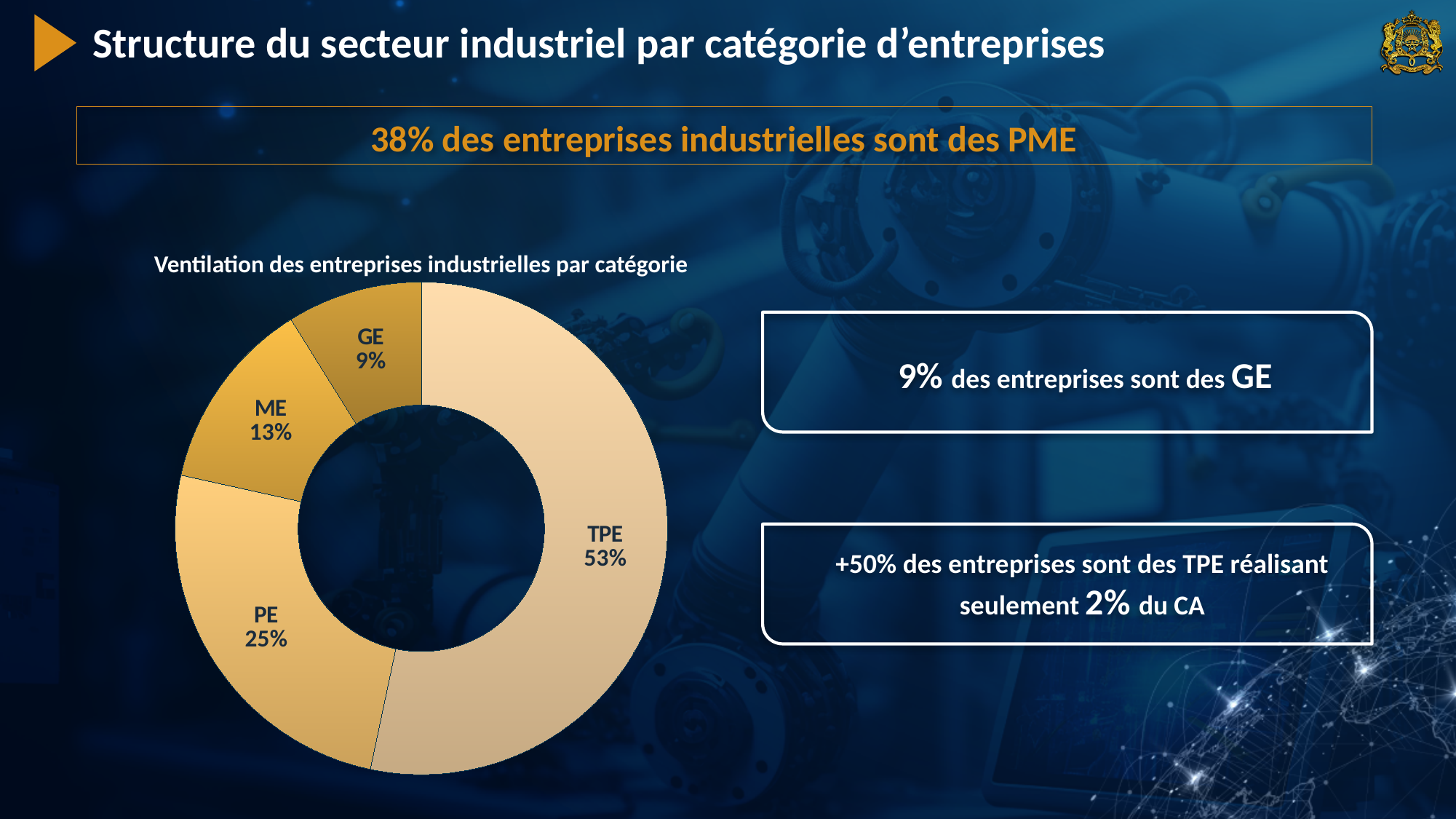
How many categories are shown in the chart? 4 What is the value shown for GE in the chart? 9% Which category has the largest share in the chart? TPE Which category has the smallest share in the chart? GE What type of chart is shown on the slide? Doughnut chart What is the difference in percentage points between TPE and PE? 28 Which is larger, the share for PE or the share for ME? PE What is the difference in percentage points between ME and GE? 4 What share of the doughnut chart does TPE represent? 53% What is the value shown for PE in the chart? 25% What is the title of the chart? Ventilation des entreprises industrielles par catégorie What is the value shown for ME in the chart? 13%